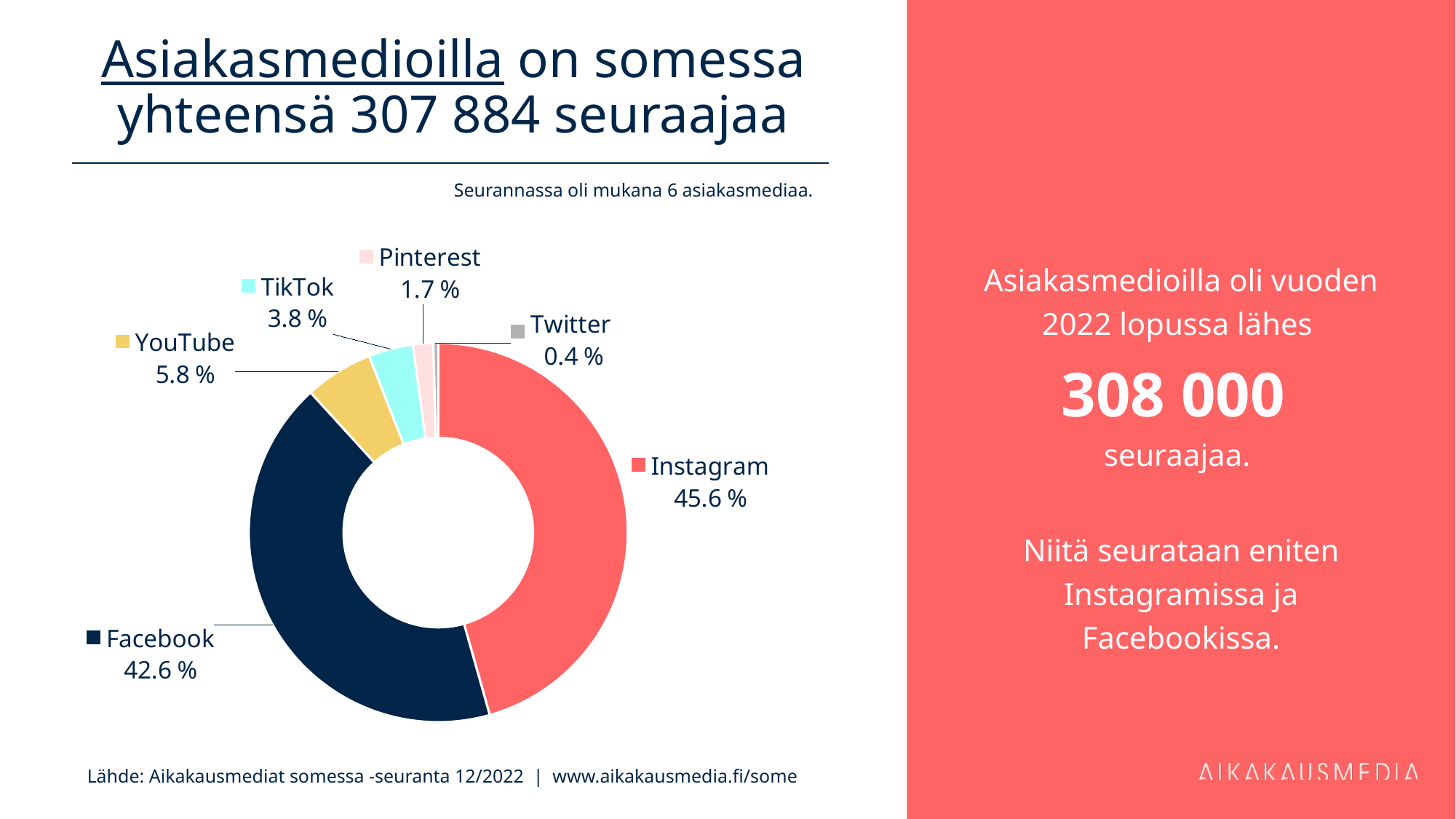
Which platform has the smallest share in the chart? Twitter What colour is the Facebook segment of the chart? Dark navy blue What kind of chart is shown on the slide? Doughnut (pie) chart What share of followers does Instagram have in the chart? 45.6 % What is the value shown for TikTok? 3.8 % What is the difference in percentage points between Instagram and Facebook? 3 percentage points What share of followers does Facebook have in the chart? 42.6 % What is the value shown for YouTube? 5.8 % How many platforms are shown in the chart? 6 Which platform has the largest share in the chart? Instagram Which has a larger share, YouTube or TikTok? YouTube What is the value shown for Pinterest? 1.7 %